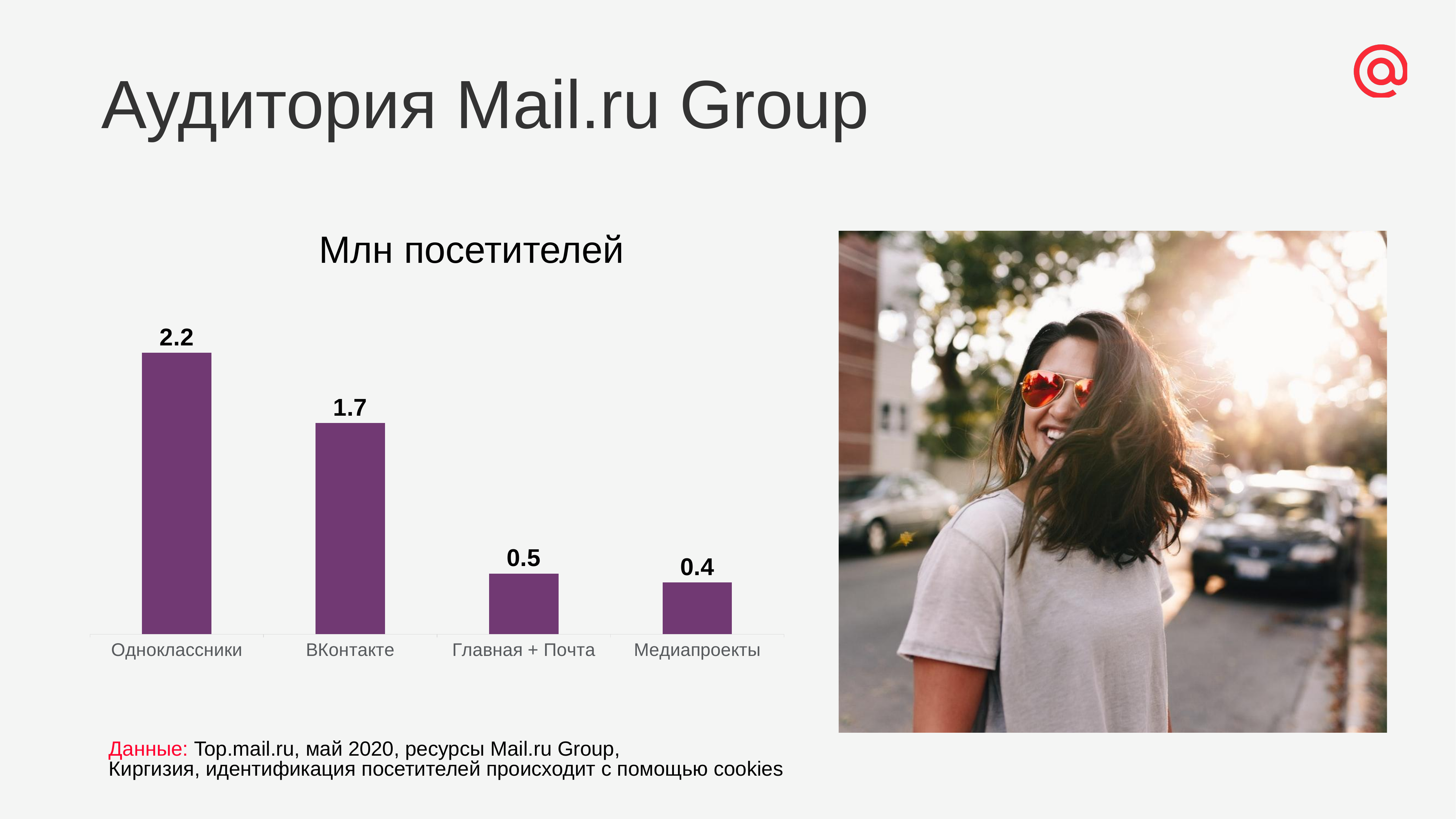
Which category has the lowest value? Медиапроекты What is the title of the chart? Млн посетителей What is the value for Одноклассники? 2.2 What is the value for Медиапроекты? 0.4 What is the difference between the values for Одноклассники and ВКонтакте? 0.5 Which is larger, the value for ВКонтакте or the value for Главная + Почта? ВКонтакте What kind of chart is shown on the slide? Bar chart What is the value for ВКонтакте? 1.7 How many categories are shown in the chart? 4 What is the value for Главная + Почта? 0.5 Which category has the highest value? Одноклассники What is the difference between the values for ВКонтакте and Главная + Почта? 1.2